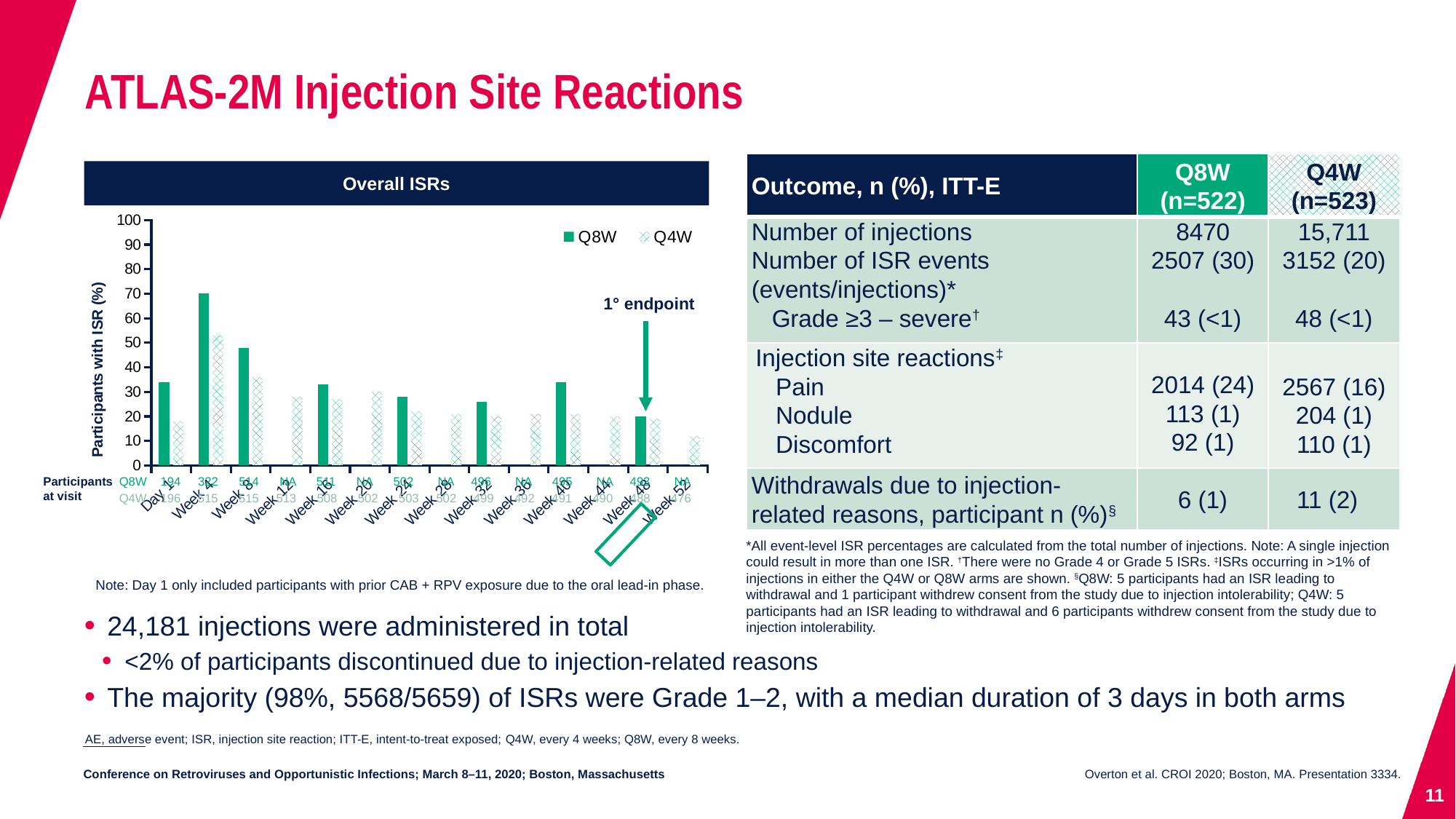
Is the Q4W value at Day 1 greater or less than 20? less How many series does the chart legend list? 2 What is the label of the chart's y axis? Participants with ISR (%) Is the Q4W value at Week 52 greater or less than 20? less At which visit is the Q8W value highest? Week 4 At Week 8, which series has the larger value, Q8W or Q4W? Q8W Is the Q8W value at Week 48 greater or less than 30? less At which visit is the Q4W value highest? Week 4 How many time points (categories) are shown along the x axis of the chart? 14 What is the title of the chart? Overall ISRs What kind of chart is shown on the slide? Bar chart